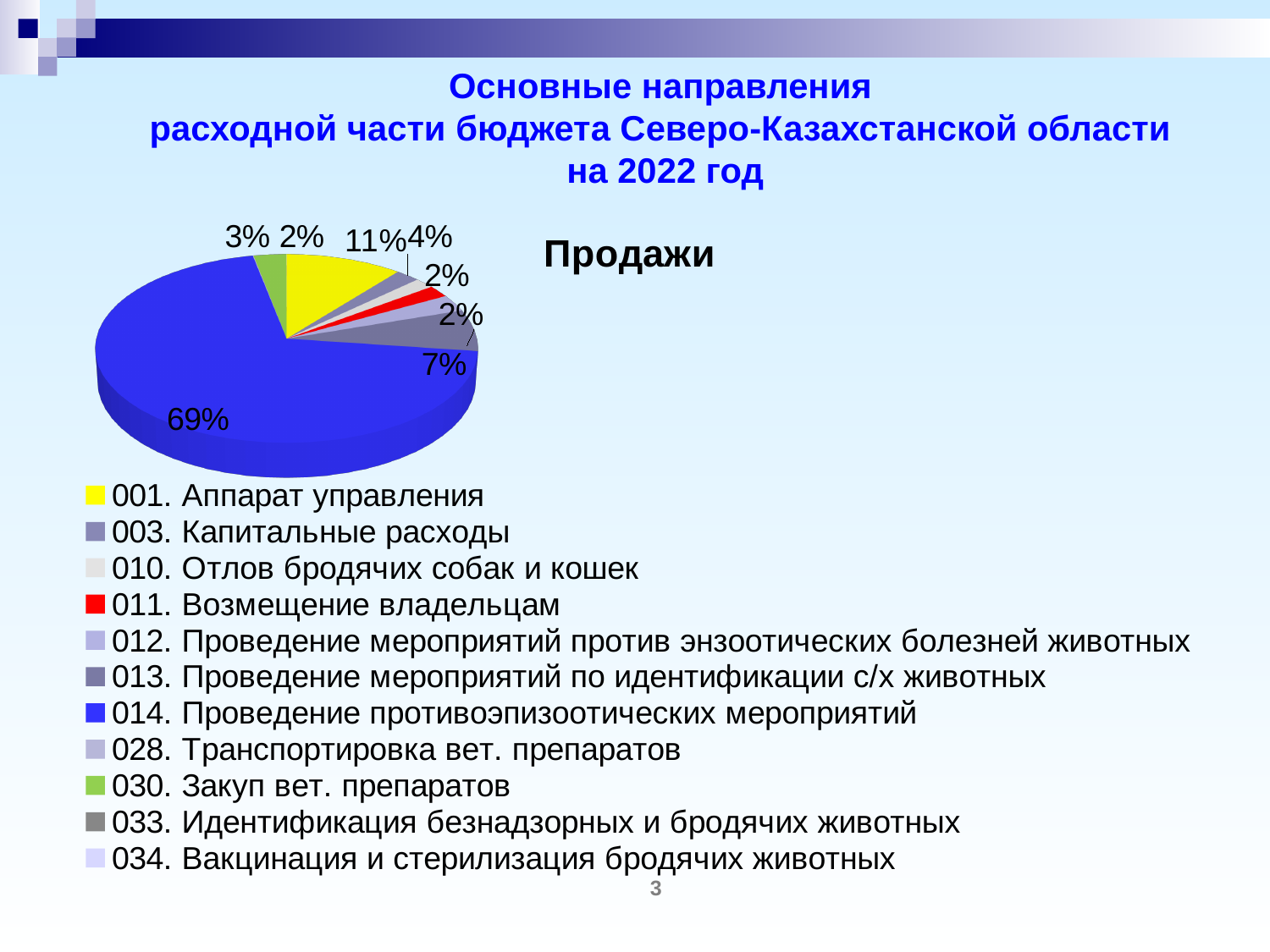
How many entries does the chart legend list? 11 What share of the pie does '001. Аппарат управления' take? 11% What colour is the largest slice of the pie? blue Which category has the largest slice of the pie? 014. Проведение противоэпизоотических мероприятий Which is larger: the slice for '001. Аппарат управления' or the slice for '030. Закуп вет. препаратов'? 001. Аппарат управления What share of the pie does '013. Проведение мероприятий по идентификации с/х животных' take? 7% Which is larger: the slice for '013. Проведение мероприятий по идентификации с/х животных' or the slice for '001. Аппарат управления'? 001. Аппарат управления What is the title of the chart? Продажи What share of the pie does '030. Закуп вет. препаратов' take? 3% What kind of chart is shown on the slide? pie chart By how many percentage points does the slice for '014. Проведение противоэпизоотических мероприятий' exceed the slice for '001. Аппарат управления'? 58